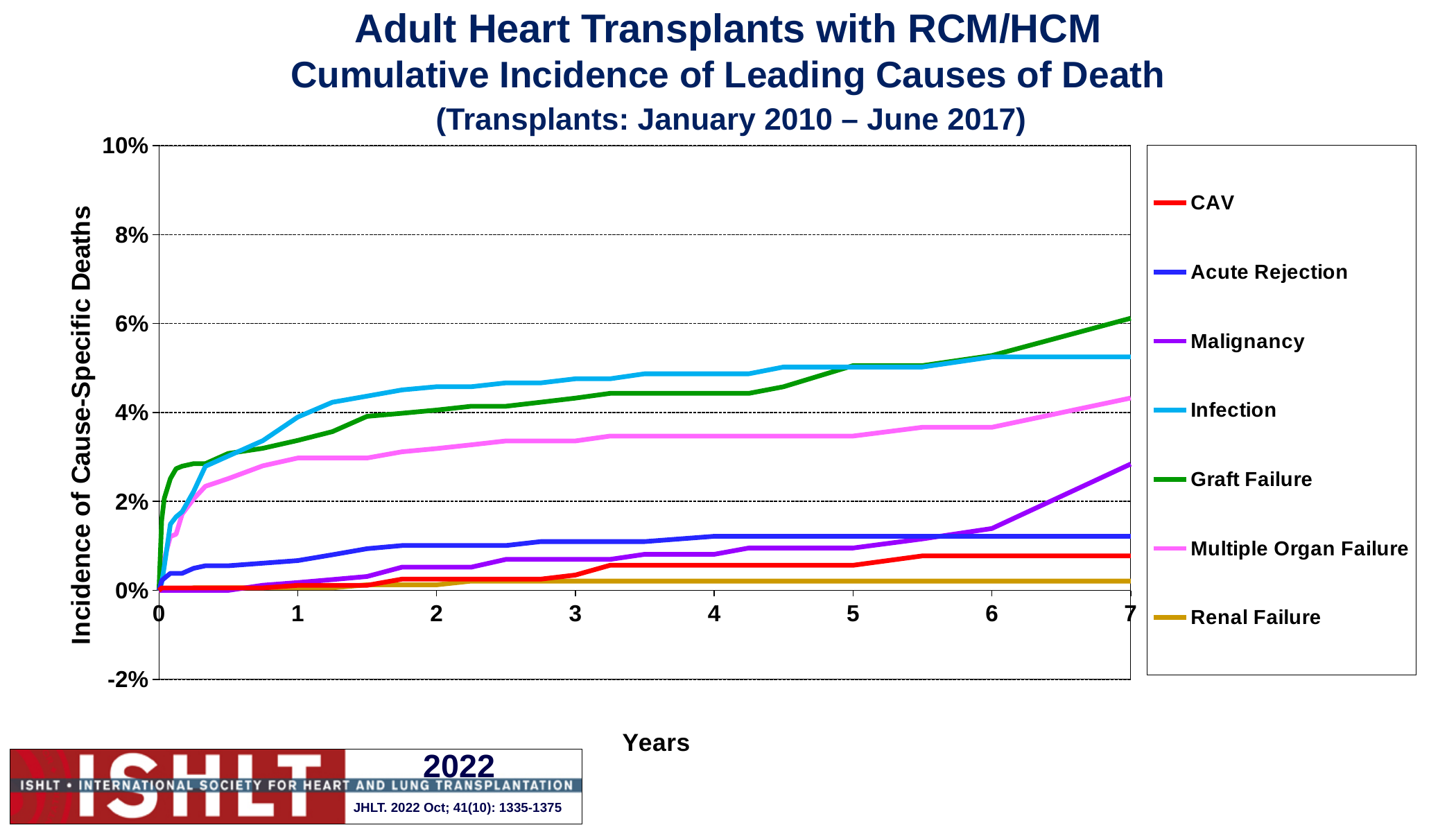
Is the value for CAV at year 7 greater or less than 2%? less What colour is the line for Infection in the legend? light blue How many series does the legend list? 7 Does the Graft Failure line rise or fall as years increase from 0 to 7? rise What kind of chart is shown on the slide? line chart Is the value for Graft Failure at year 7 greater or less than 6%? greater Which cause of death has the highest cumulative incidence at year 7? Graft Failure Is the value for Multiple Organ Failure at year 7 greater or less than 4%? greater Which cause of death has the lowest cumulative incidence at year 7? Renal Failure At year 7, which is larger: the value for Infection or the value for Multiple Organ Failure? Infection